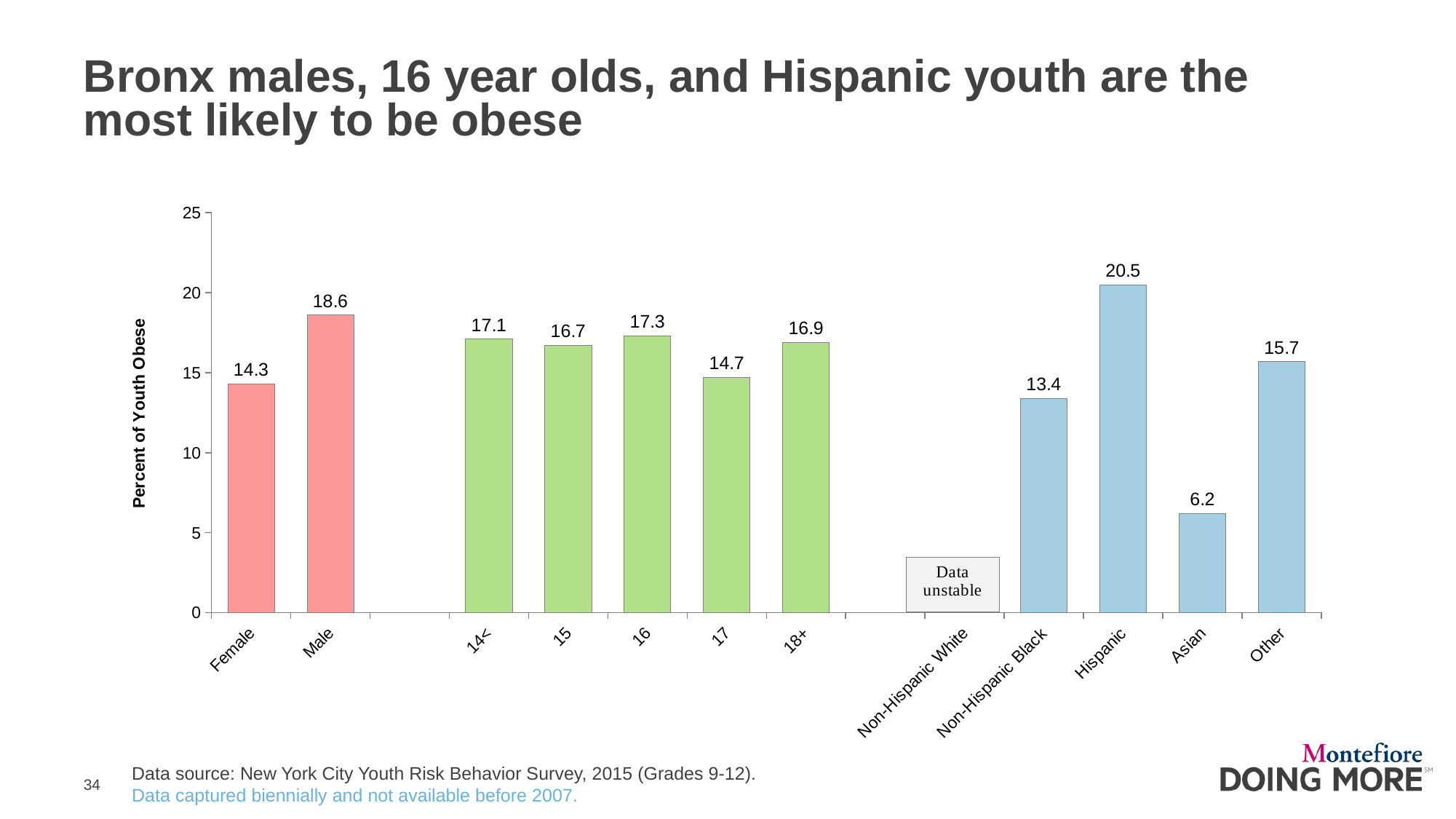
Which category has the lowest percent of youth obese among those with a plotted value? Asian Is the value for Non-Hispanic Black greater or less than 15? less What is the percent of youth obese for Asian youth? 6.2 What is the difference in percent of youth obese between Male and Female? 4.3 What is the label of the y axis? Percent of Youth Obese Which category is marked as having unstable data instead of a plotted value? Non-Hispanic White What kind of chart is shown on the slide? bar chart Which category has the highest percent of youth obese? Hispanic What is the percent of youth obese for Male? 18.6 What is the percent of youth obese for 17 year olds? 14.7 What is the percent of youth obese for Hispanic youth? 20.5 Which has a higher percent of youth obese, 16 year olds or 17 year olds? 16